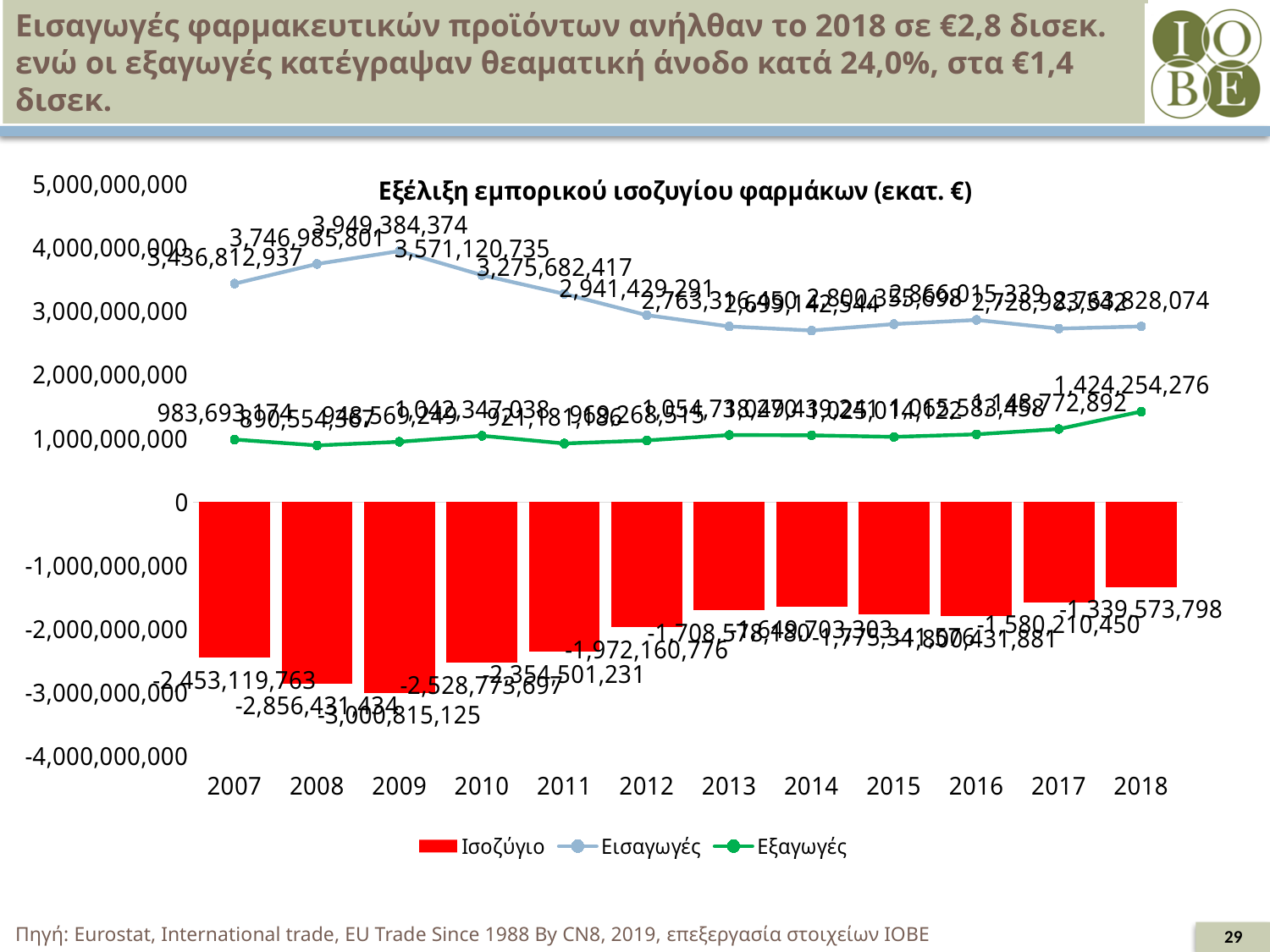
What is the value of Εξαγωγές (exports) for 2018? 1,424,254,276 What is the value of Ισοζύγιο (balance) for 2018? -1,339,573,798 In which year were Εισαγωγές (imports) highest? 2009 Is the value of Εξαγωγές for 2018 greater or less than 1,000,000,000? greater Which is larger, Εισαγωγές in 2008 or Εισαγωγές in 2012? 2008 What is the value of Εισαγωγές (imports) for 2007? 3,436,812,937 How many years are shown on the x axis? 12 What is the title of the chart? Εξέλιξη εμπορικού ισοζυγίου φαρμάκων (εκατ. €) In which year was the Ισοζύγιο (balance) most negative? 2009 How many series does the legend list? 3 What is the value of Εισαγωγές (imports) for 2009? 3,949,384,374 What is the value of Ισοζύγιο (balance) for 2009? -3,000,815,125